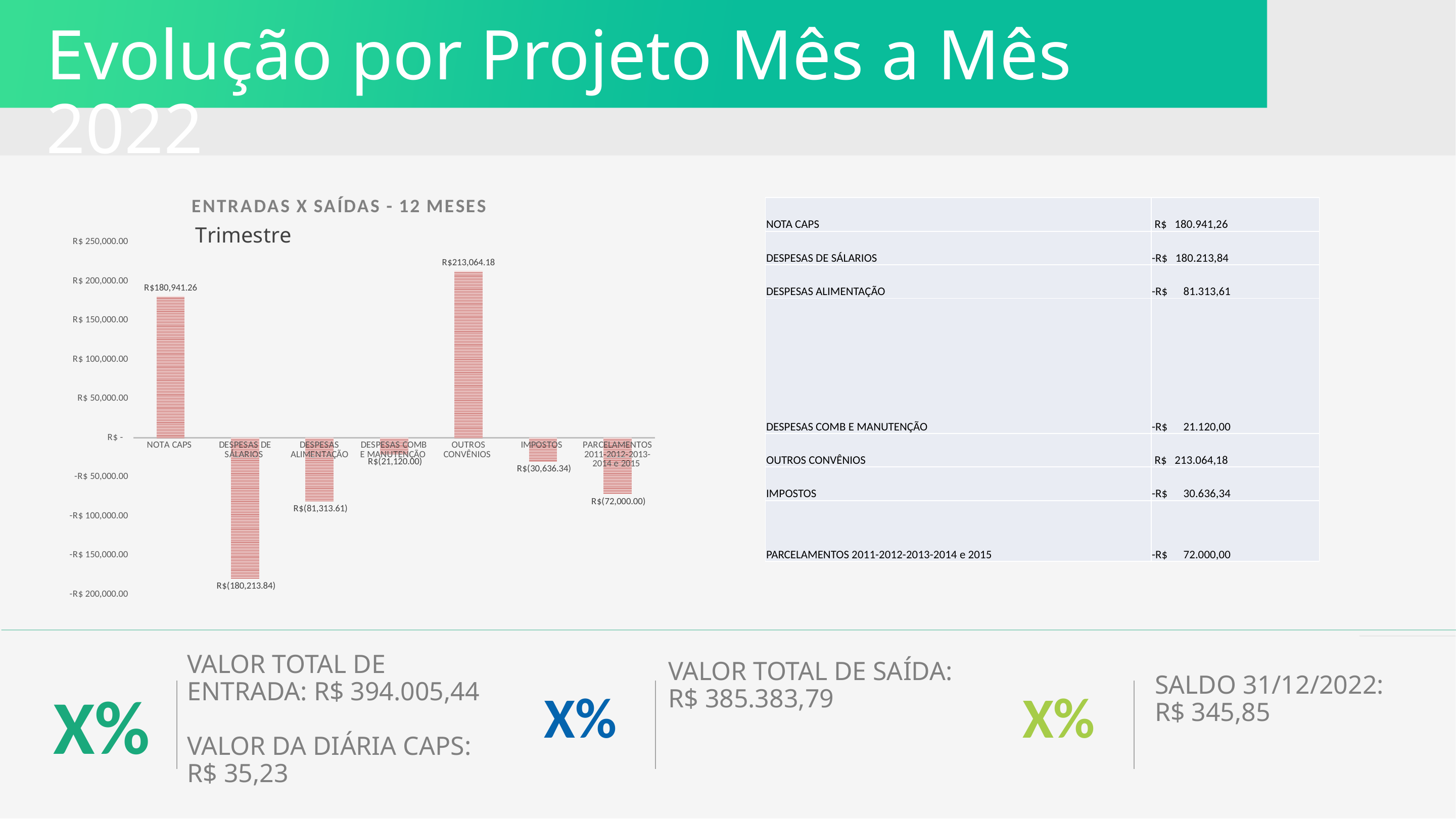
Which category has the lowest value in the chart? DESPESAS DE SÁLARIOS What is the value for DESPESAS DE SÁLARIOS in the chart? R$(180,213.84) What kind of chart is shown on the slide? bar chart What is the value for OUTROS CONVÊNIOS in the chart? R$213,064.18 What is the value for IMPOSTOS in the chart? R$(30,636.34) What is the title of the chart? ENTRADAS X SAÍDAS - 12 MESES Which category has the highest value in the chart? OUTROS CONVÊNIOS Which is larger in value: NOTA CAPS or OUTROS CONVÊNIOS? OUTROS CONVÊNIOS What is the value for NOTA CAPS in the chart? R$180,941.26 How many categories are shown on the x axis of the chart? 7 Is the value for NOTA CAPS greater or less than R$ 150,000.00? greater What is the difference between the values for OUTROS CONVÊNIOS and NOTA CAPS? R$32,122.92